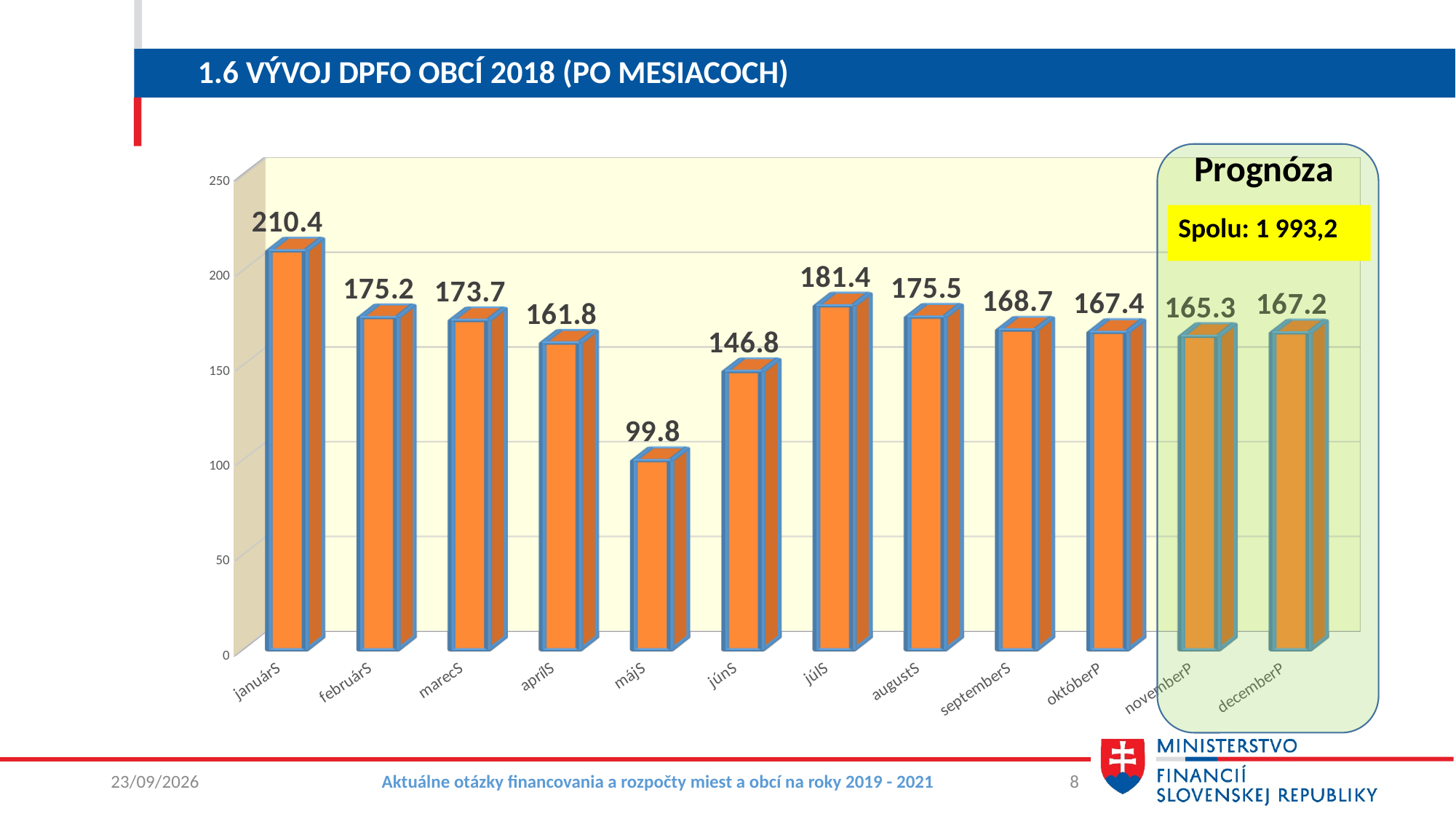
What is the difference between the values for januárS and májS? 110.6 What is the value for januárS? 210.4 Which month has the highest value? januárS What total is shown in the yellow 'Spolu' box in the Prognóza area? 1 993,2 Is the value for júnS greater or less than 150? less Which is larger, the value for júlS or the value for augustS? júlS How many months are shown on the x axis? 12 Which month has the lowest value? májS What kind of chart is shown on the slide? bar chart What is the difference between the values for júlS and júnS? 34.6 What is the value for májS? 99.8 What is the value for decemberP? 167.2